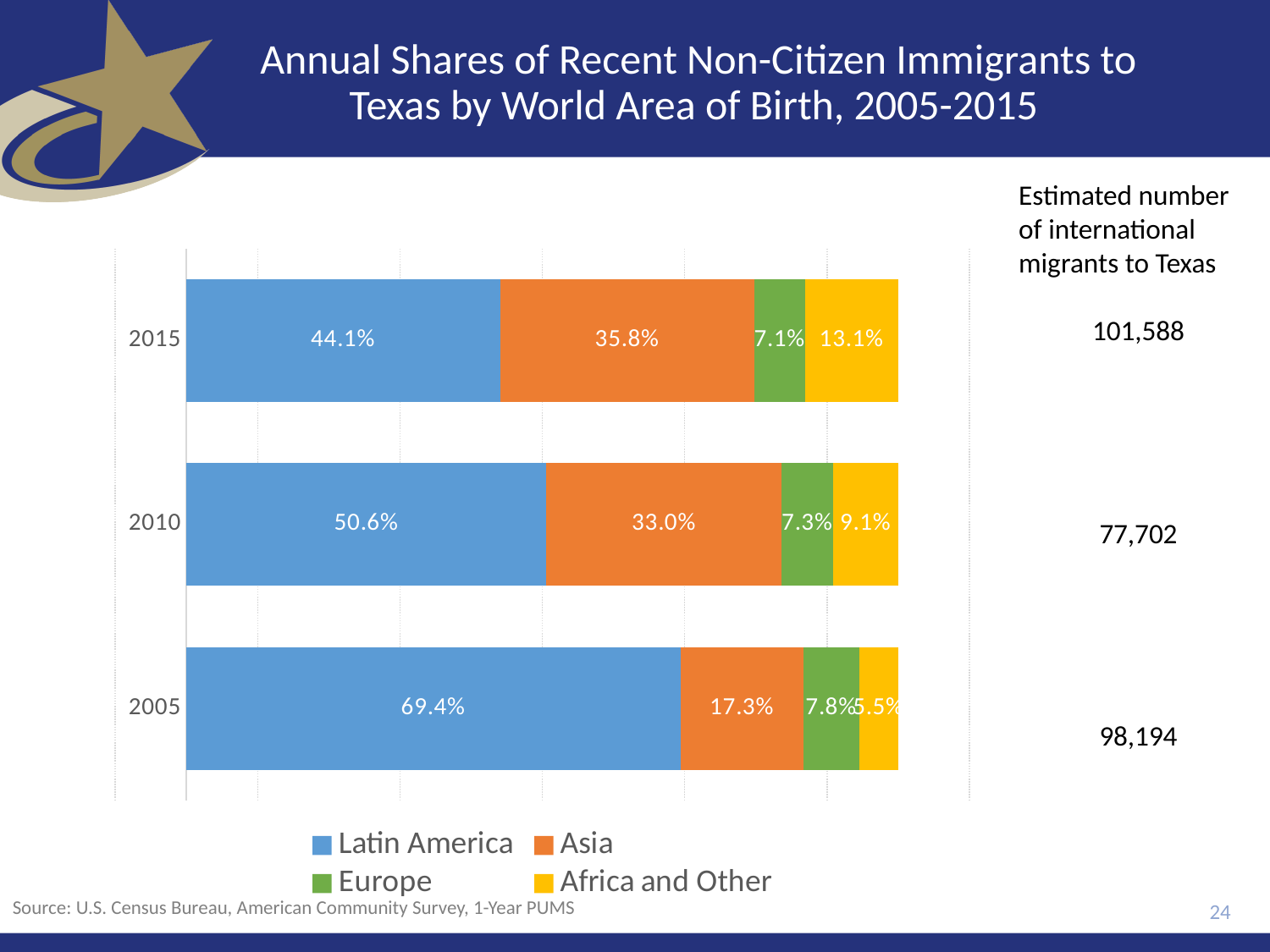
In which year was the Asia share the lowest? 2005 What share of recent non-citizen immigrants to Texas in 2015 were from Latin America? 44.1% What is the Europe share for 2005? 7.8% What is the Africa and Other share for 2015? 13.1% In 2015, which was larger: the Asia share or the Africa and Other share? Asia Which colour represents Asia in the chart? Orange In which year was the Latin America share the highest? 2005 By how many percentage points did the Latin America share fall from 2005 to 2015? 25.3 percentage points What kind of chart is shown on the slide? Stacked bar chart How many series does the legend list? 4 What is the Asia share for 2010? 33.0% How many years are shown in the chart? 3